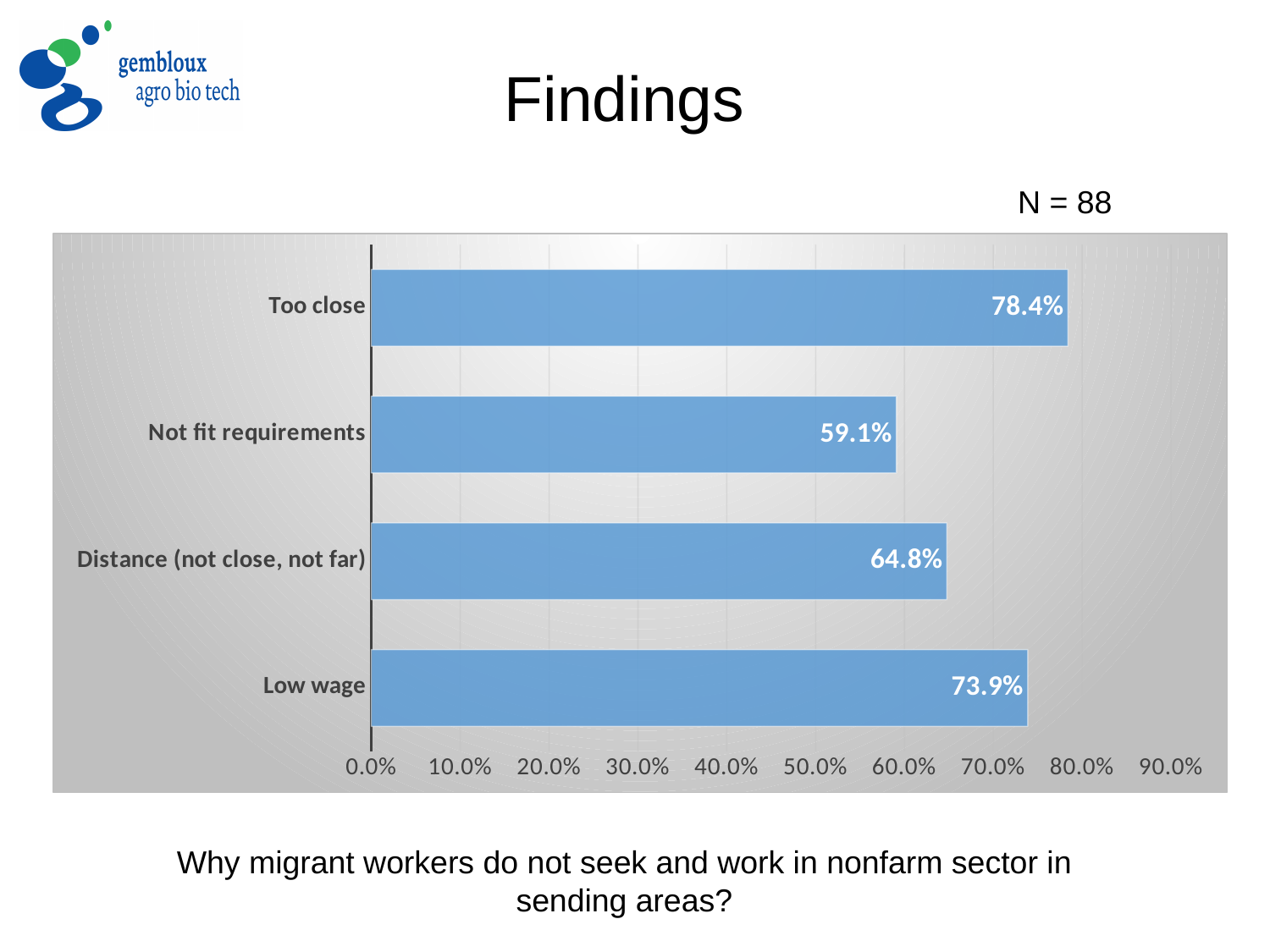
Which is larger, the value for Low wage or the value for Distance (not close, not far)? Low wage What kind of chart is shown on the slide? bar chart What is the value for Not fit requirements? 59.1% What is the value for Low wage? 73.9% Which category has the highest value? Too close Which category has the lowest value? Not fit requirements What is the difference between the values for Too close and Low wage? 4.5% How many categories are shown in the chart? 4 Is the value for Not fit requirements greater or less than 60.0%? less What is the difference between the values for Distance (not close, not far) and Not fit requirements? 5.7% What is the value for Too close? 78.4% What is the value for Distance (not close, not far)? 64.8%